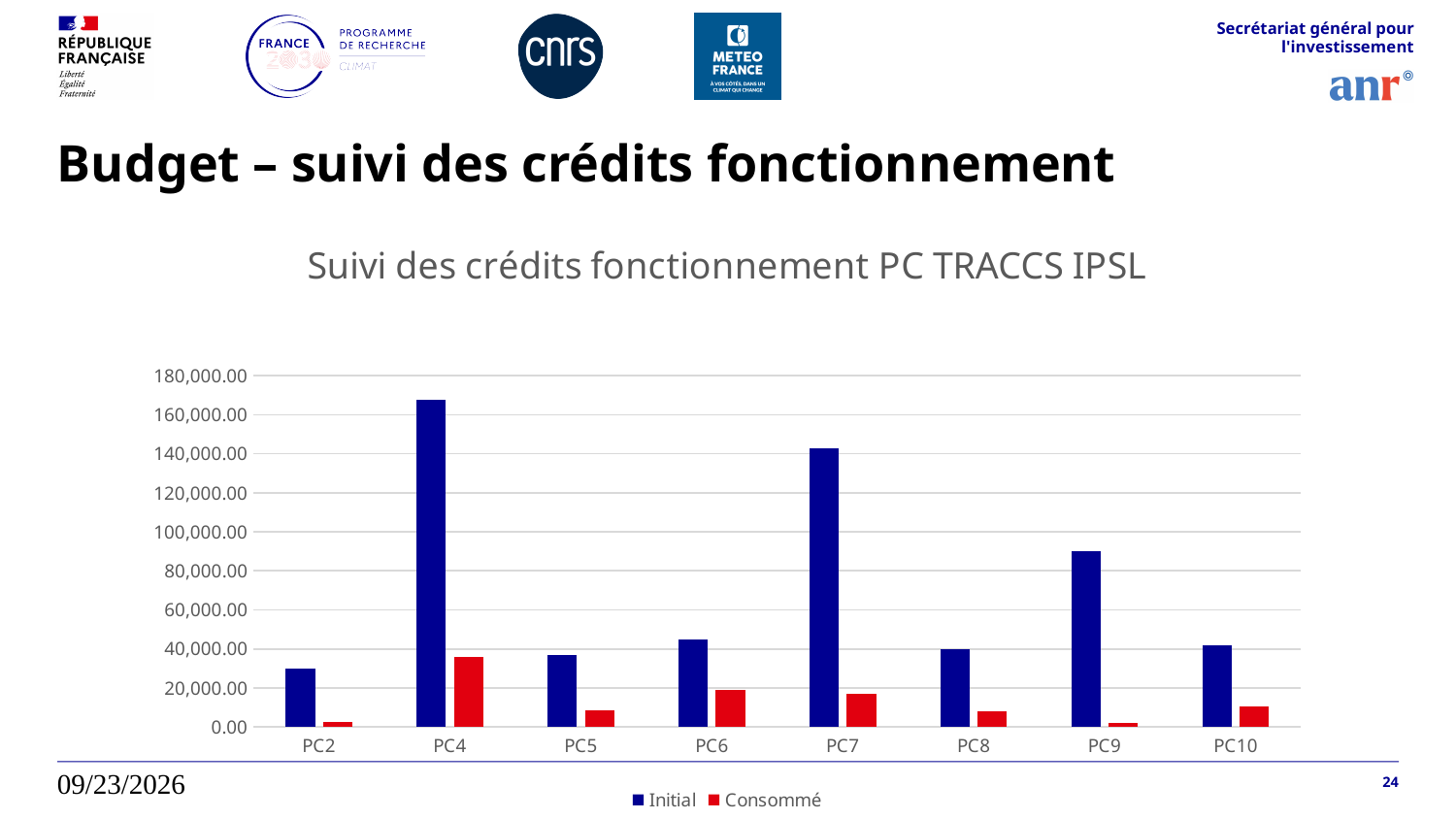
Is the Consommé value for PC4 greater or less than 40,000.00? less Is the Initial value for PC9 greater or less than 80,000.00? greater Which PC has the lowest Initial value? PC2 How many series does the legend list? 2 Is the Initial value for PC4 greater or less than 160,000.00? greater Which PC has the highest Initial value? PC4 Which colour represents the Consommé series in the legend? red Which PC has the highest Consommé value? PC4 Which is larger, the Initial value for PC7 or the Initial value for PC9? PC7 What kind of chart is shown on the slide? bar chart What is the title of the chart? Suivi des crédits fonctionnement PC TRACCS IPSL How many PC categories are shown on the x axis? 8